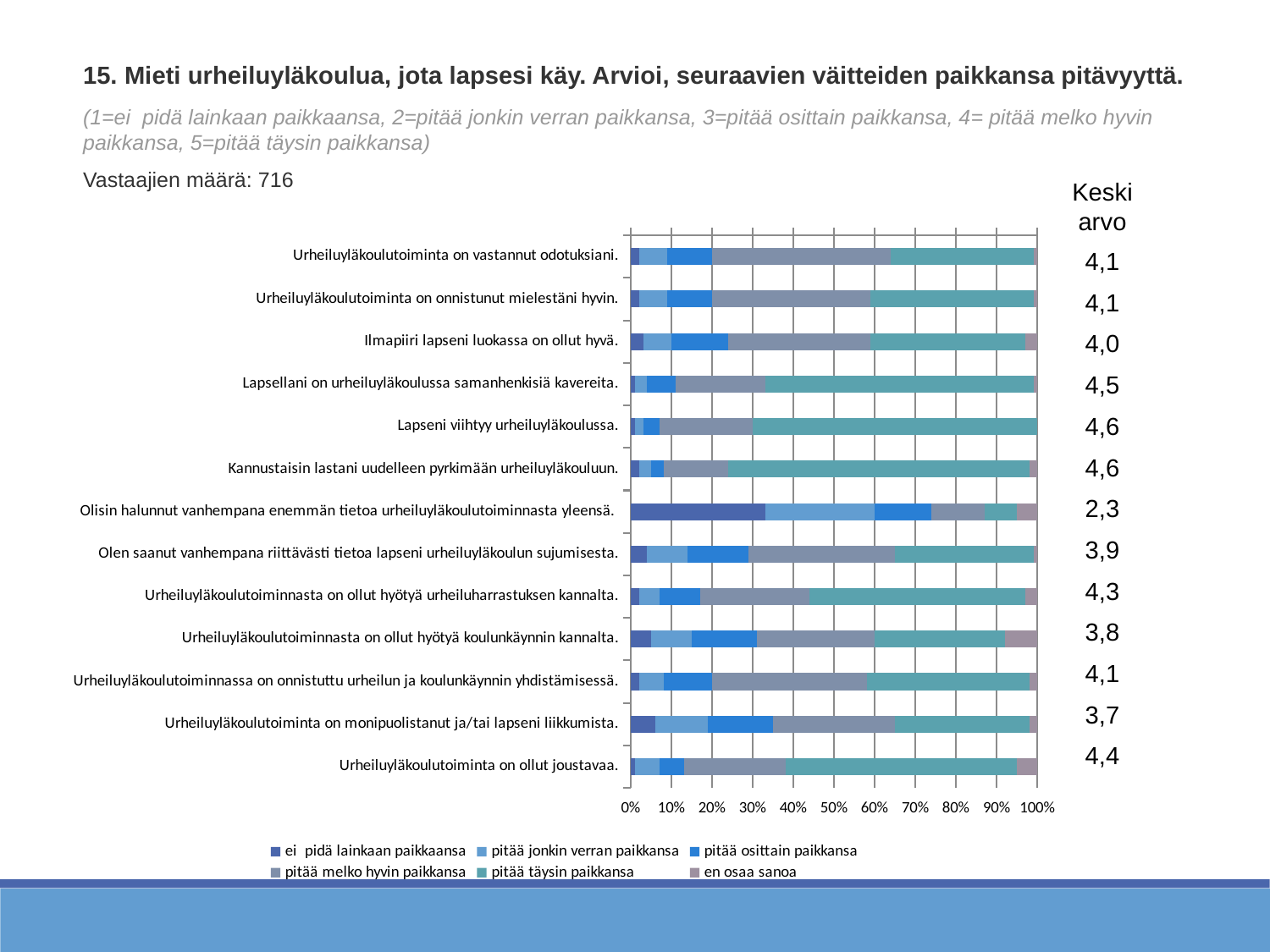
How many statements (categories) are plotted in the chart? 13 Which statement has the lowest Keskiarvo (mean) value? Olisin halunnut vanhempana enemmän tietoa urheiluyläkoulutoiminnasta yleensä. What is the Keskiarvo (mean) shown for "Lapseni viihtyy urheiluyläkoulussa."? 4,6 How many series does the chart legend list? 6 Is the "pitää täysin paikkansa" share for "Lapseni viihtyy urheiluyläkoulussa." greater or less than 60%? greater Is the "ei pidä lainkaan paikkaansa" share for "Olisin halunnut vanhempana enemmän tietoa urheiluyläkoulutoiminnasta yleensä." greater or less than 20%? greater What kind of chart is shown on the slide? bar chart What is the difference between the Keskiarvo for "Kannustaisin lastani uudelleen pyrkimään urheiluyläkouluun." (4,6) and for "Olisin halunnut vanhempana enemmän tietoa urheiluyläkoulutoiminnasta yleensä." (2,3)? 2,3 What is the Keskiarvo (mean) shown for "Urheiluyläkoulutoiminta on ollut joustavaa."? 4,4 Which has the higher Keskiarvo: "Lapsellani on urheiluyläkoulussa samanhenkisiä kavereita." or "Ilmapiiri lapseni luokassa on ollut hyvä."? Lapsellani on urheiluyläkoulussa samanhenkisiä kavereita. What is the last entry listed in the chart legend? en osaa sanoa What is the Keskiarvo (mean) shown for "Olisin halunnut vanhempana enemmän tietoa urheiluyläkoulutoiminnasta yleensä."? 2,3